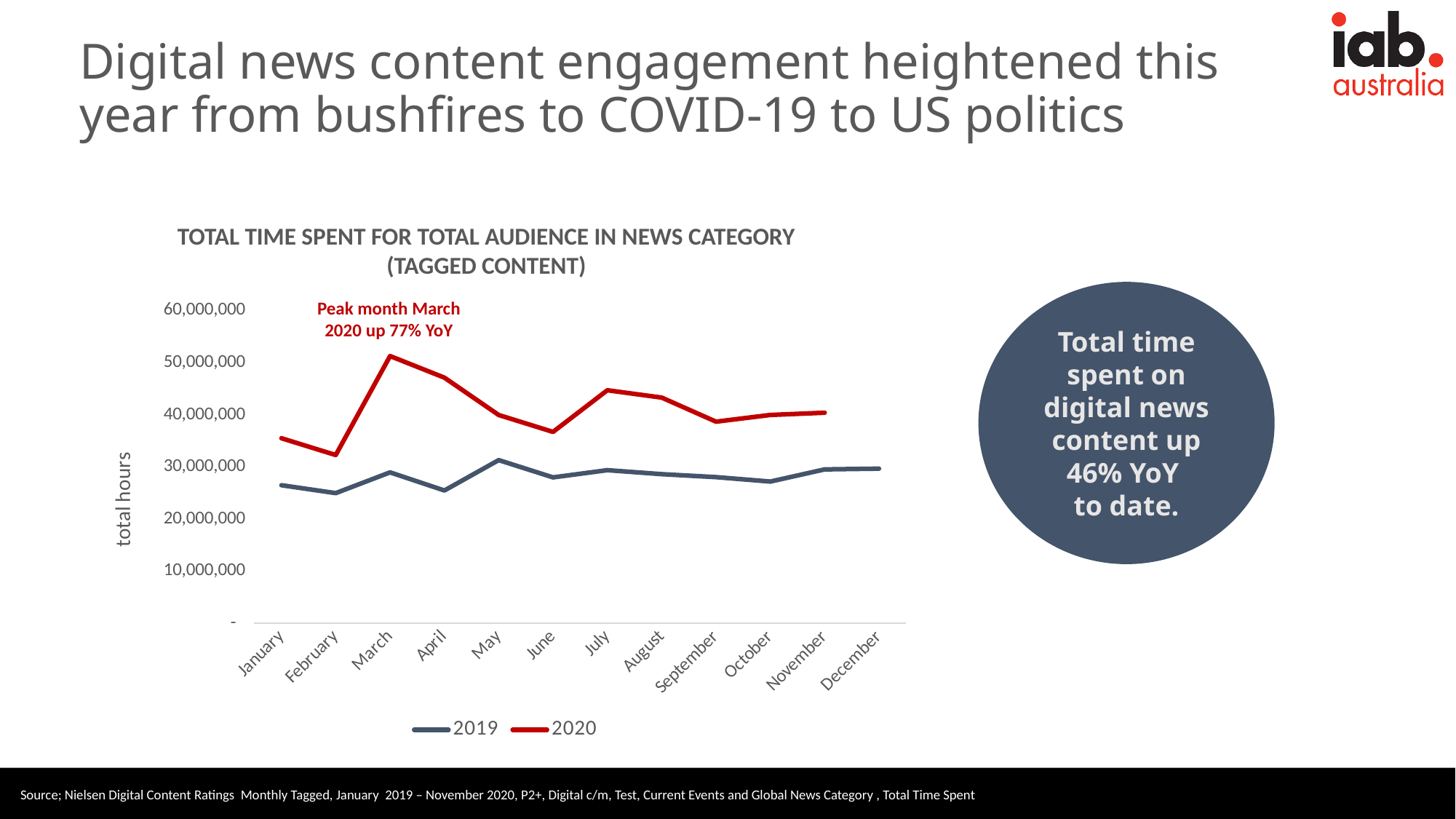
How many months are shown on the x axis? 12 In which month does the 2020 line reach its highest value? March What kind of chart is shown on the slide? line chart How many series does the legend list? 2 Is the value for 2019 in January greater or less than 30,000,000? less Is the value for 2020 in March greater or less than 40,000,000? greater In which month does the 2020 line reach its lowest value? February Which series has the larger value in March, 2019 or 2020? 2020 Is the value for 2020 in June greater or less than 40,000,000? less According to the annotation on the chart, by what percentage was the peak month March 2020 up year on year? 77% Does the 2020 line rise or fall from March to June? fall In which month does the 2019 line reach its highest value? May